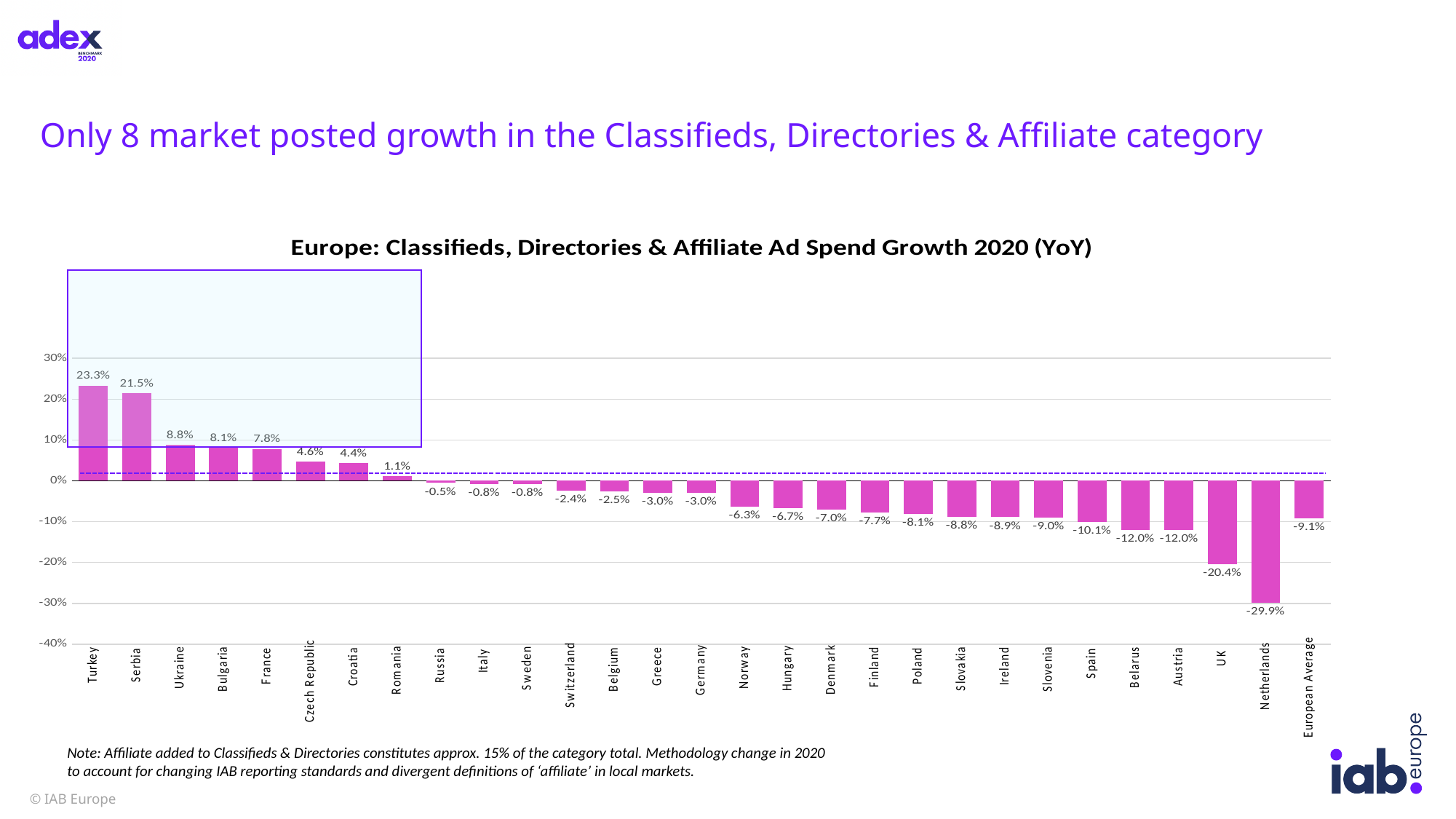
What is the value for the European Average? -9.1% Is the value for Turkey greater or less than 20%? greater Which market has the lowest growth? Netherlands What is the value for Turkey? 23.3% What is the difference between the values for Turkey and Serbia? 1.8 percentage points What is the difference between the values for the UK and the Netherlands? 9.5 percentage points What kind of chart is shown? Bar chart What is the value for the Netherlands? -29.9% How many bars are plotted in the chart? 29 Do the values rise or fall moving from left to right across the markets (excluding the European Average)? Fall Which is larger, the value for Bulgaria or the value for France? Bulgaria Which market has the highest growth? Turkey